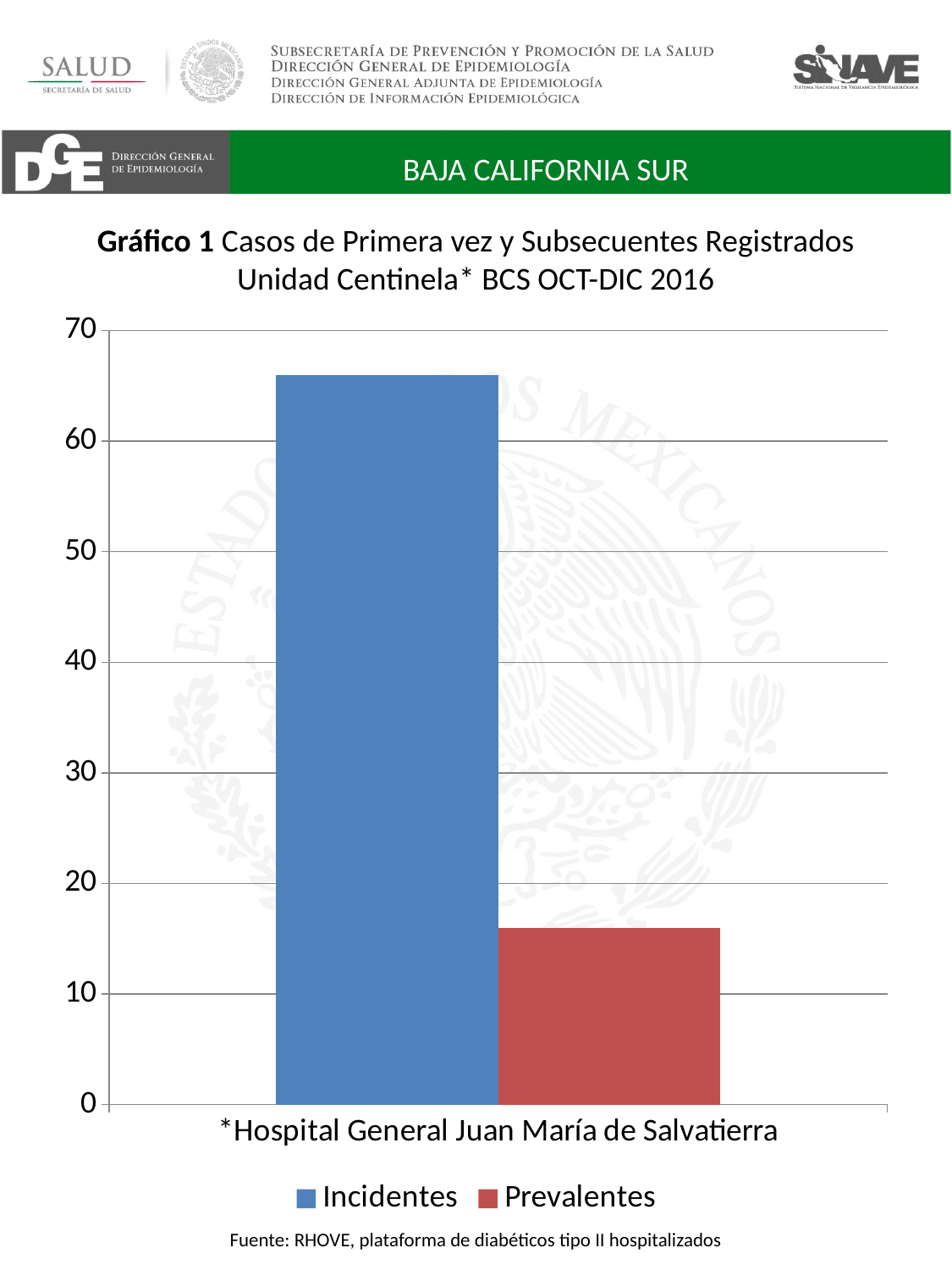
How many series does the legend list? 2 Is the value for Incidentes greater or less than 60? greater Which series has the taller bar, Incidentes or Prevalentes? Incidentes How many categories are shown on the x axis? 1 What kind of chart is shown on the slide? bar chart Which series has the lowest value? Prevalentes Is the value for Incidentes greater or less than 70? less What is the category label shown on the x axis? *Hospital General Juan María de Salvatierra What colour is the bar for Prevalentes? red Is the value for Prevalentes greater or less than 10? greater Which series has the highest value? Incidentes